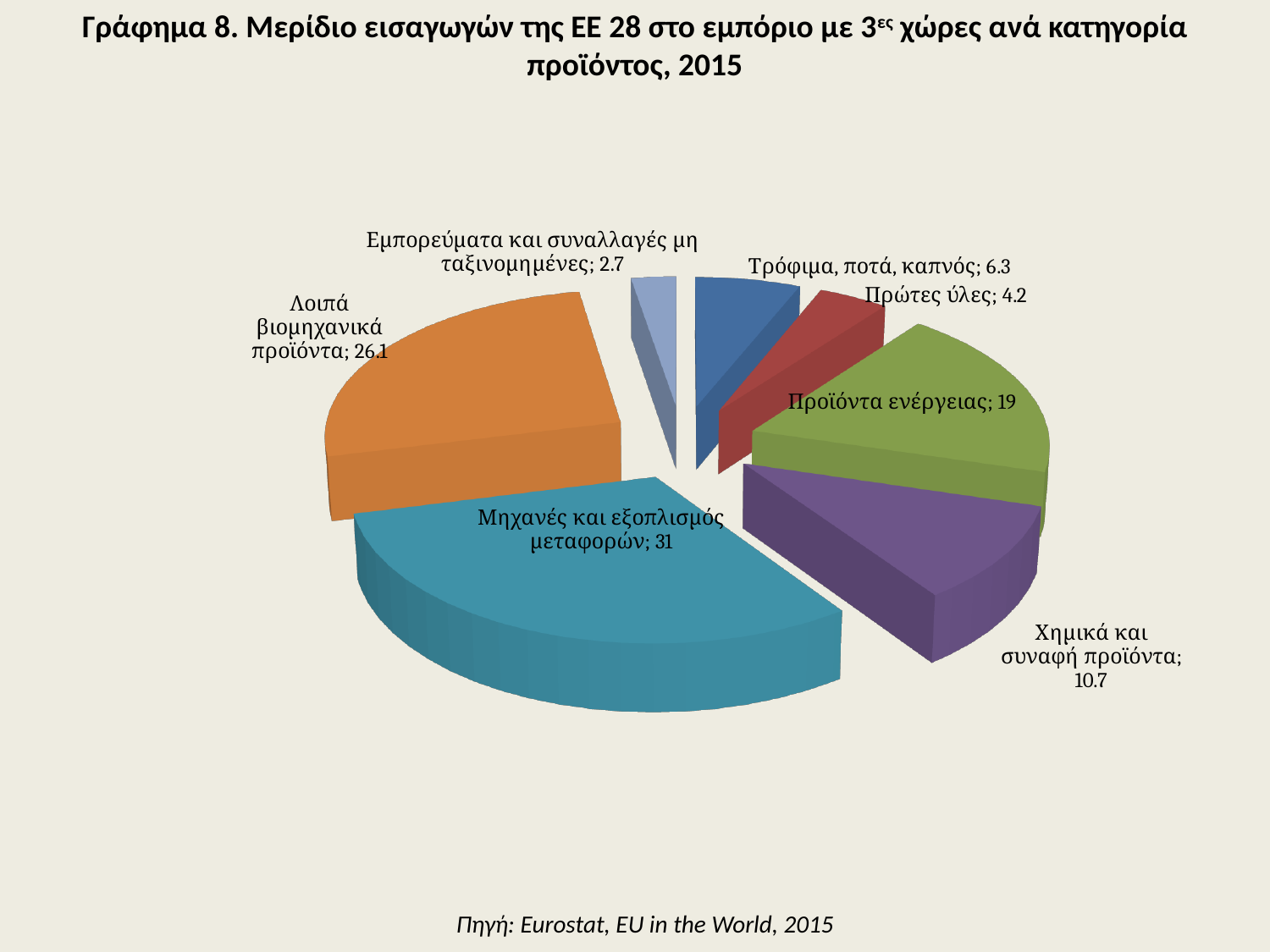
What is the difference between the values for Μηχανές και εξοπλισμός μεταφορών and Λοιπά βιομηχανικά προϊόντα? 4.9 What source is cited below the chart? Eurostat, EU in the World, 2015 What is the value shown for Χημικά και συναφή προϊόντα? 10.7 Which category has the smallest share of the pie? Εμπορεύματα και συναλλαγές μη ταξινομημένες Which category has the largest share of the pie? Μηχανές και εξοπλισμός μεταφορών What is the value shown for Προϊόντα ενέργειας? 19 Which is larger, the value for Τρόφιμα, ποτά, καπνός or the value for Πρώτες ύλες? Τρόφιμα, ποτά, καπνός What is the value shown for Εμπορεύματα και συναλλαγές μη ταξινομημένες? 2.7 What is the difference between the values for Προϊόντα ενέργειας and Χημικά και συναφή προϊόντα? 8.3 What type of chart is shown on the slide? Pie chart What is the value shown for Μηχανές και εξοπλισμός μεταφορών? 31 How many categories (slices) does the pie chart have? 7